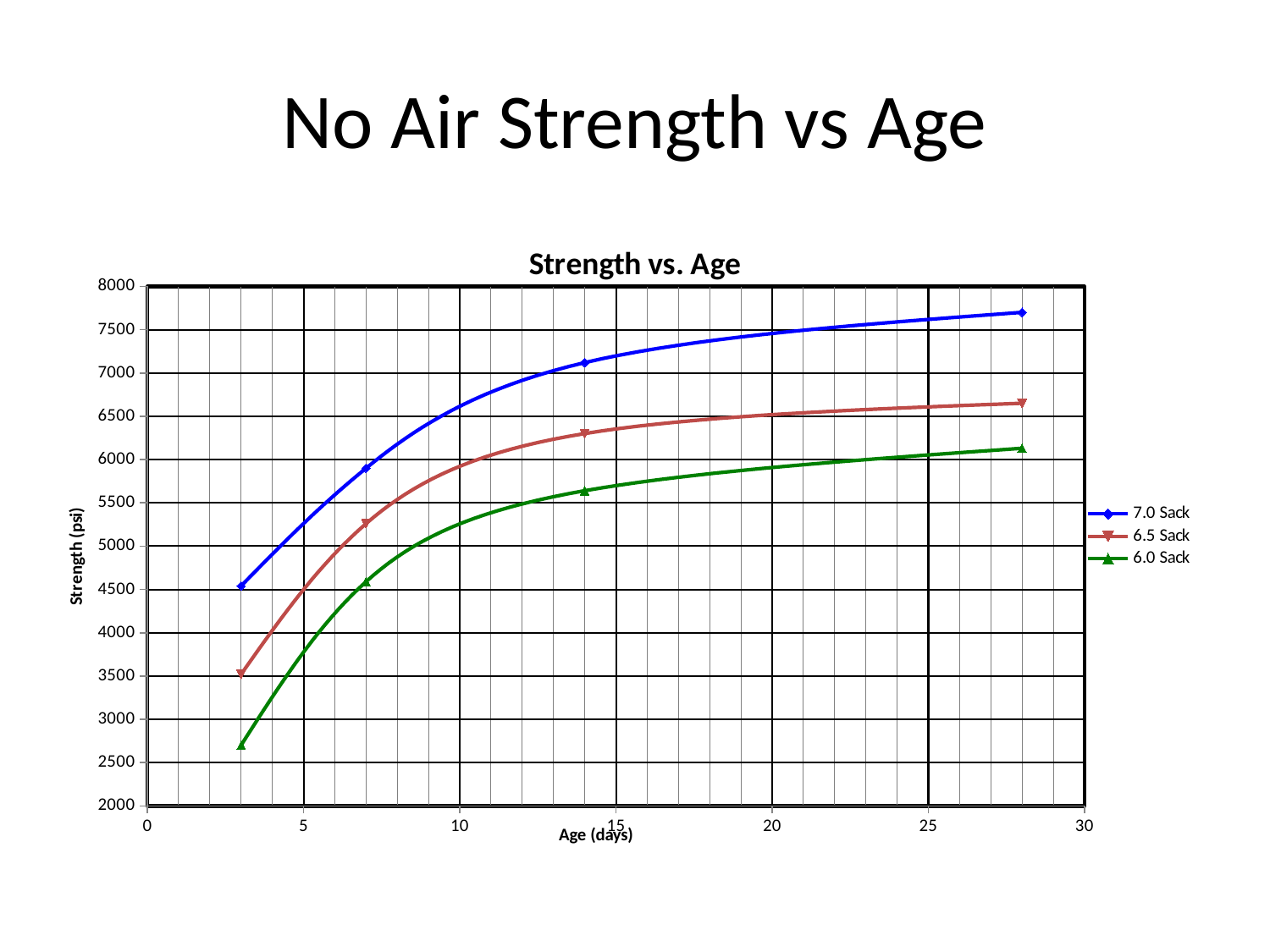
Do the strength values rise or fall as age increases? rise What kind of chart is shown on the slide? line chart How many data points are plotted for the 7.0 Sack series? 4 Which series has the highest strength at 28 days? 7.0 Sack Is the strength of the 6.0 Sack series at 3 days greater or less than 3000? less Which series has the lowest strength at 3 days? 6.0 Sack Which is larger: the 6.5 Sack strength at 28 days or the 7.0 Sack strength at 14 days? 7.0 Sack strength at 14 days Is the strength of the 6.0 Sack series at 7 days greater or less than 5000? less Is the strength of the 6.5 Sack series at 14 days greater or less than 6000? greater How many series does the legend list? 3 What is the label on the vertical axis of the chart? Strength (psi)